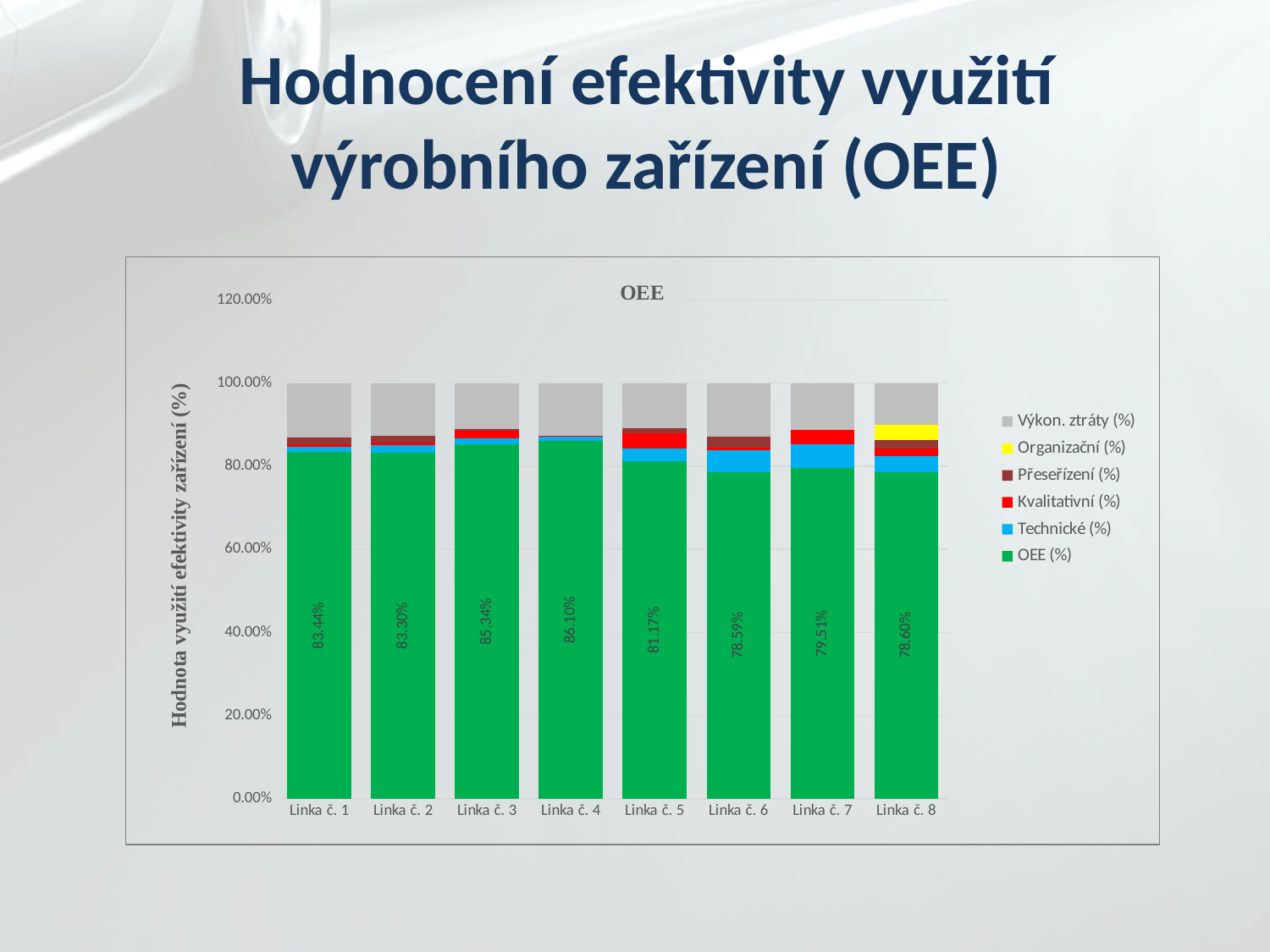
Which has a larger OEE (%) value, Linka č. 3 or Linka č. 5? Linka č. 3 What is the OEE (%) value for Linka č. 6? 78.59% What is the OEE (%) value for Linka č. 1? 83.44% Is the OEE (%) value for Linka č. 8 greater or less than 80.00%? less Which line (Linka) has the highest OEE (%) value? Linka č. 4 What is the difference between the OEE (%) values of Linka č. 4 and Linka č. 1? 2.66% How many series does the chart legend list? 6 What is the title of the chart? OEE Which legend entry is shown in yellow? Organizační (%) How many lines (Linka) are shown on the x axis of the chart? 8 What kind of chart is shown on the slide? Stacked bar chart What is the OEE (%) value for Linka č. 4? 86.10%